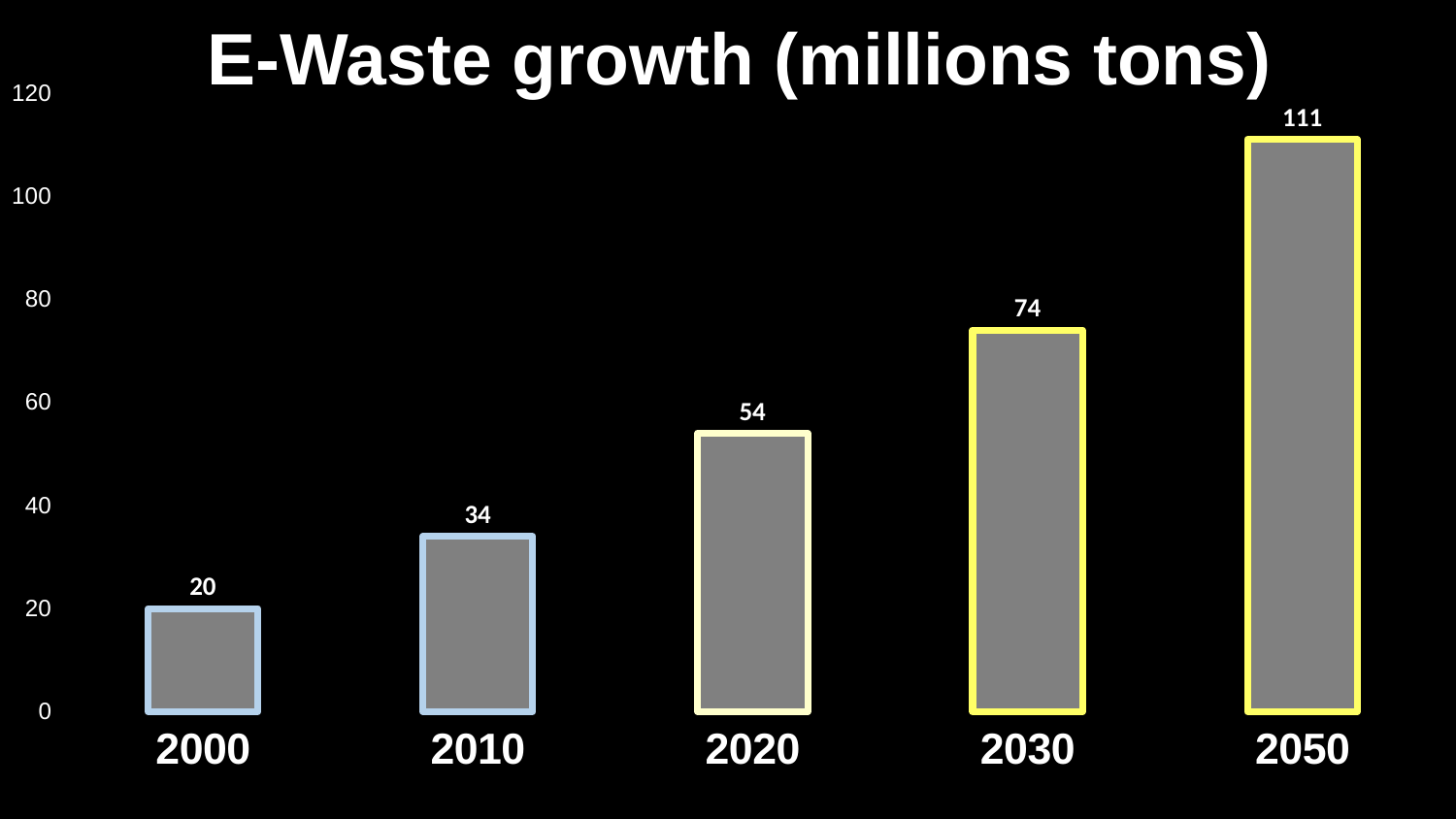
What is the difference between the values for 2050 and 2000? 91 Which year has the lowest e-waste value? 2000 What kind of chart is shown on the slide? Bar chart What is the e-waste value for 2020? 54 What is the difference between the values for 2030 and 2010? 40 What is the e-waste value for 2000? 20 Do the values rise or fall from 2000 to 2050? Rise How many years are shown on the chart? 5 What is the e-waste value for 2050? 111 Which is larger, the value for 2010 or the value for 2020? 2020 Which year has the highest e-waste value? 2050 Is the value for 2030 greater or less than 60? greater